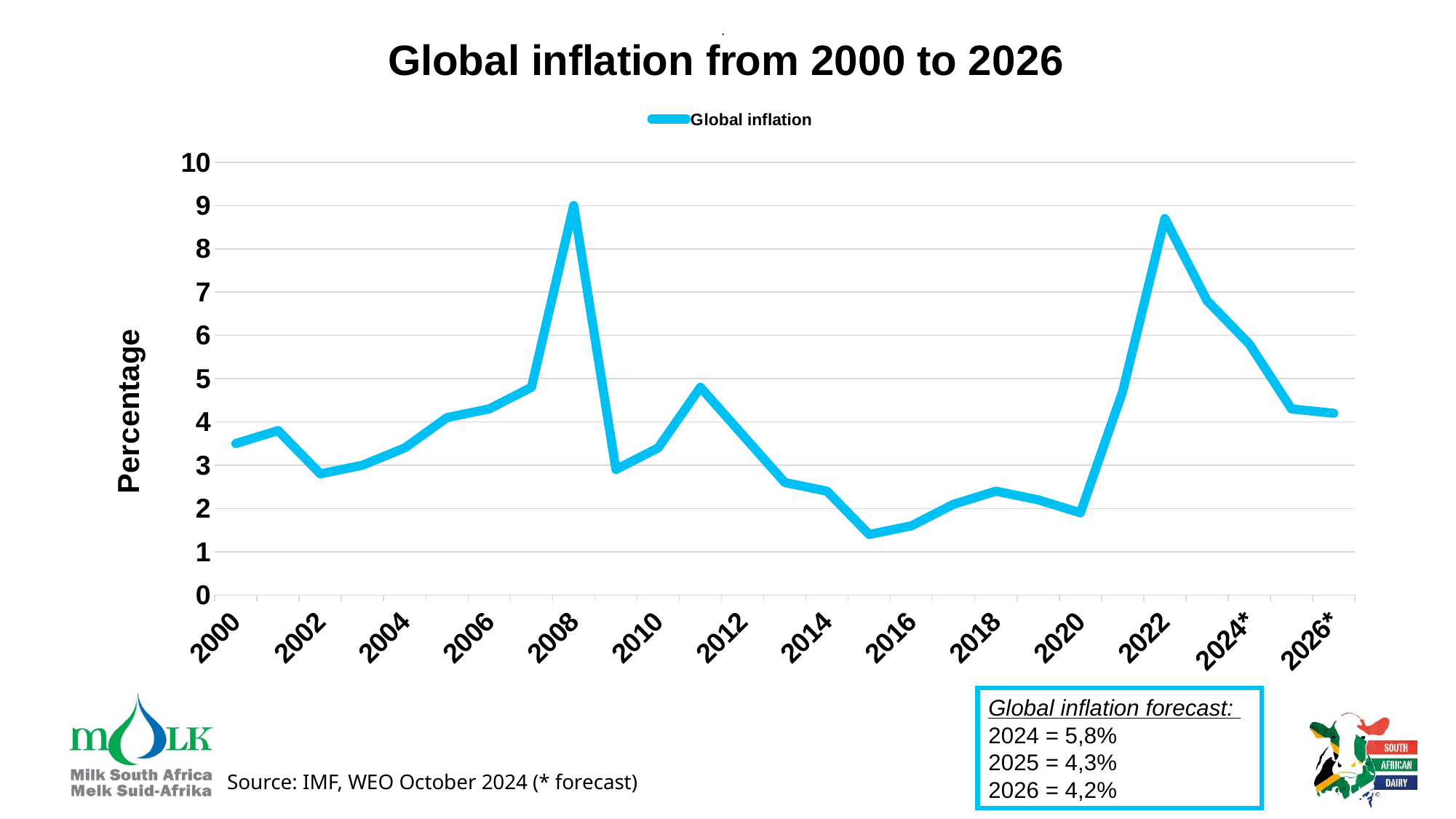
In which year does global inflation reach its highest value on the chart? 2008 Is the value for global inflation in 2022 greater or less than 8? greater How many series does the legend list? 1 What is the global inflation forecast for 2025? 4,3% Is the value for global inflation in 2015 greater or less than 2? less What kind of chart is shown on the slide? line chart By how many percentage points does the forecast global inflation for 2024 exceed the forecast for 2025? 1,5 What is the global inflation forecast for 2024? 5,8% What is the title of the chart? Global inflation from 2000 to 2026 Which is larger, the forecast global inflation for 2024 or for 2025? 2024 Does global inflation rise or fall from 2022 to 2026 on the chart? fall What is the global inflation forecast for 2026? 4,2%